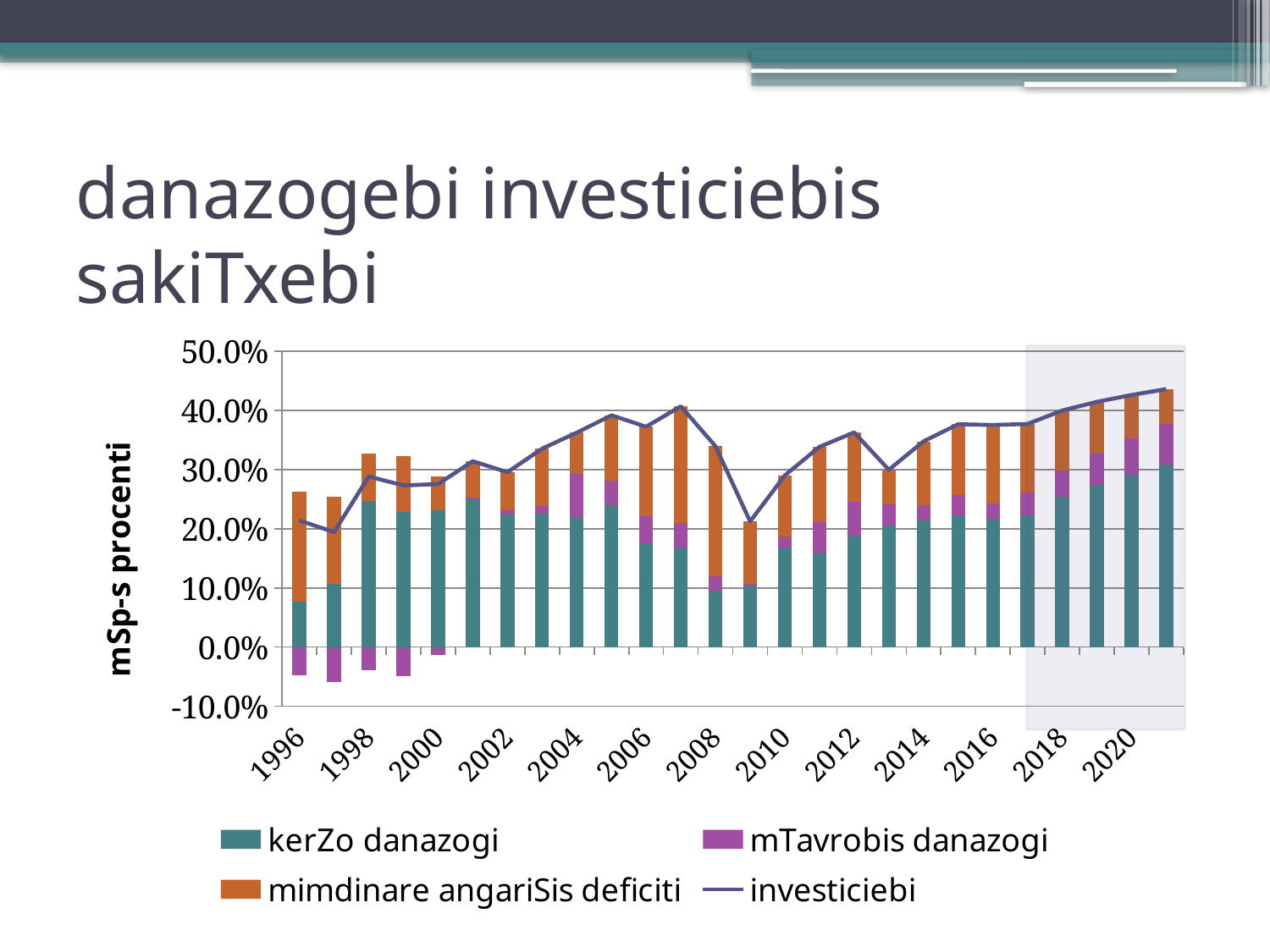
How many years (bars) are plotted on the x axis? 26 Does the investiciebi line rise or fall from 2017 to 2021? rise Is the value of the investiciebi line for 2021 greater or less than 40.0%? greater How many series does the legend list? 4 Which year has the larger investiciebi value, 2009 or 2012? 2012 Which series is drawn as a line rather than bars? investiciebi Is the mTavrobis danazogi value for 1997 greater or less than 0.0%? less What kind of chart is shown on the slide? A stacked bar chart with a line Is the value of the investiciebi line for 2009 greater or less than 30.0%? less In which year does the investiciebi line reach its highest value? 2021 What is the title of the y axis? mSp-s procenti